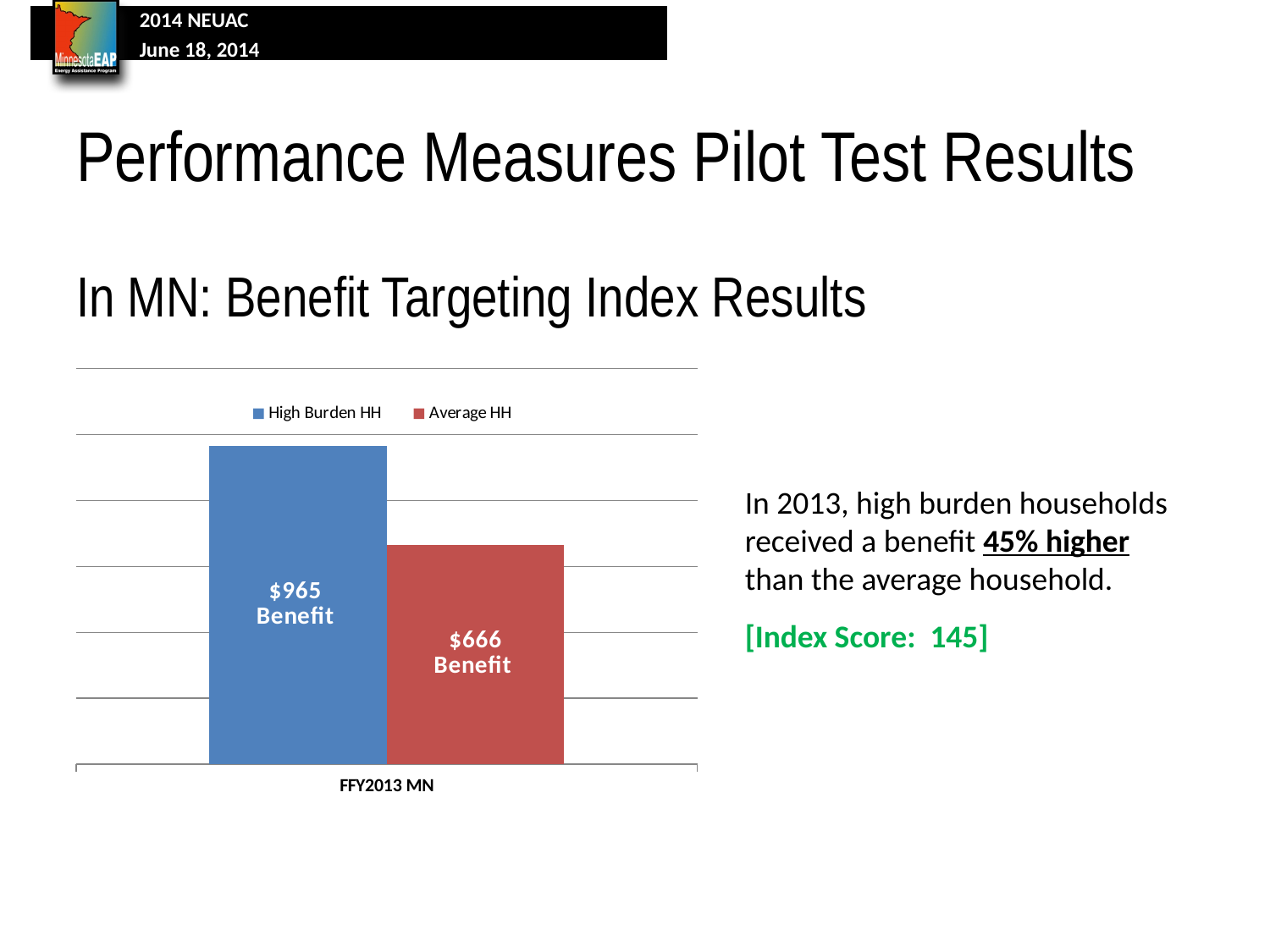
What kind of chart is shown on the slide? bar chart How many series does the legend list? 2 What is the difference between the High Burden HH benefit and the Average HH benefit? $299 Which series has the higher benefit value? High Burden HH What benefit value is shown for High Burden HH? $965 What benefit value is shown for Average HH? $666 What colour is the bar for Average HH? red Is the benefit for High Burden HH larger or smaller than the benefit for Average HH? larger What is the category label on the x axis of the chart? FFY2013 MN Which series has the lower benefit value? Average HH How many categories are shown on the x axis? 1